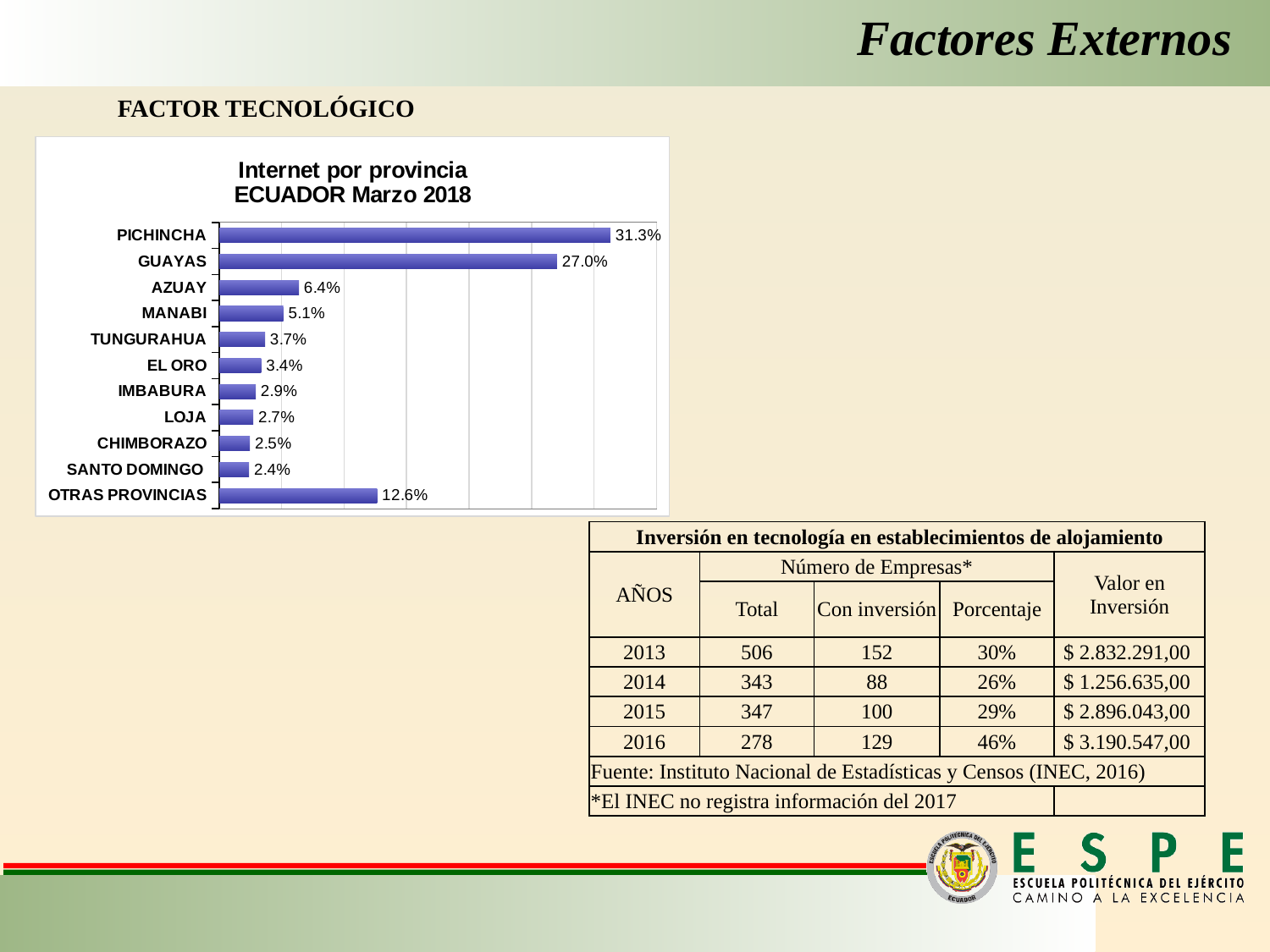
In the 'Internet por provincia' chart, which is larger, the value for EL ORO or the value for IMBABURA? EL ORO What is the difference between the values for AZUAY and MANABI in the 'Internet por provincia' chart? 1.3% What is the value for PICHINCHA in the 'Internet por provincia ECUADOR Marzo 2018' chart? 31.3% What is the value for TUNGURAHUA in the 'Internet por provincia' chart? 3.7% What is the value for OTRAS PROVINCIAS in the 'Internet por provincia' chart? 12.6% Which province has the highest value in the 'Internet por provincia' chart? PICHINCHA What is the title of the chart on the slide? Internet por provincia ECUADOR Marzo 2018 How many categories are shown in the 'Internet por provincia' chart? 11 What is the difference between the values for PICHINCHA and GUAYAS in the 'Internet por provincia' chart? 4.3% What kind of chart is 'Internet por provincia ECUADOR Marzo 2018'? Bar chart In the 'Internet por provincia' chart, which is larger, the value for OTRAS PROVINCIAS or the value for AZUAY? OTRAS PROVINCIAS Which category has the lowest value in the 'Internet por provincia' chart? SANTO DOMINGO